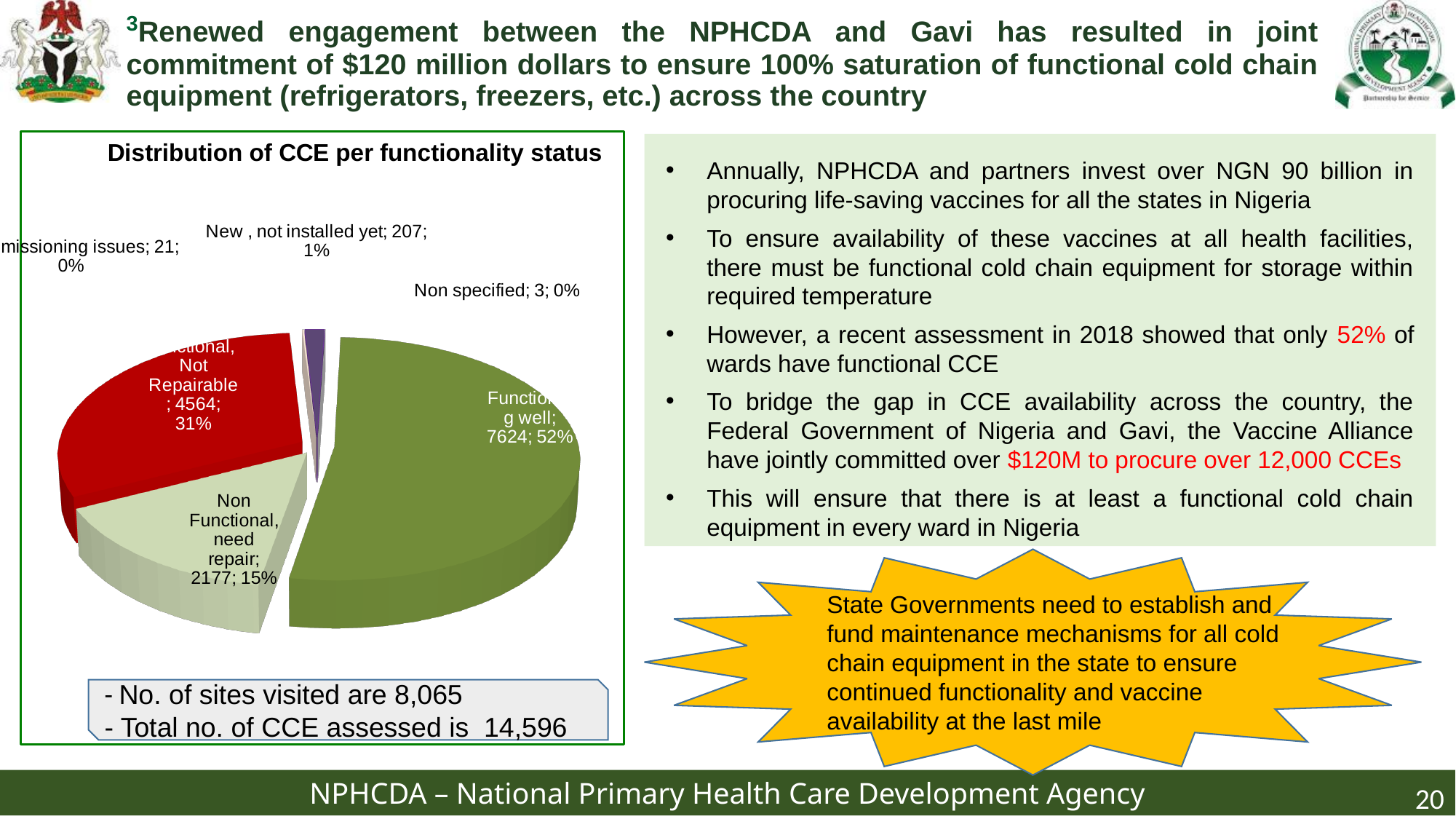
Which category has the smallest slice in the pie chart? Non specified What percentage share of the pie chart is "Functioning well"? 52% What is the value shown for the "New, not installed yet" slice? 207 What is the difference between the "Functioning well" count (7624) and the "Non Functional, need repair" count (2177)? 5447 How many CCE are labelled as "Functioning well" in the pie chart? 7624 How many CCE are in the "Non Functional, need repair" slice? 2177 What is the title of the chart on the slide? Distribution of CCE per functionality status What is the value shown for the "Non specified" slice? 3 Which category has the largest slice in the pie chart? Functioning well What percentage of the pie is "Non Functional, need repair"? 15% What kind of chart is shown under the title "Distribution of CCE per functionality status"? Pie chart Which is larger: the "Non Functional, need repair" slice or the "New, not installed yet" slice? Non Functional, need repair